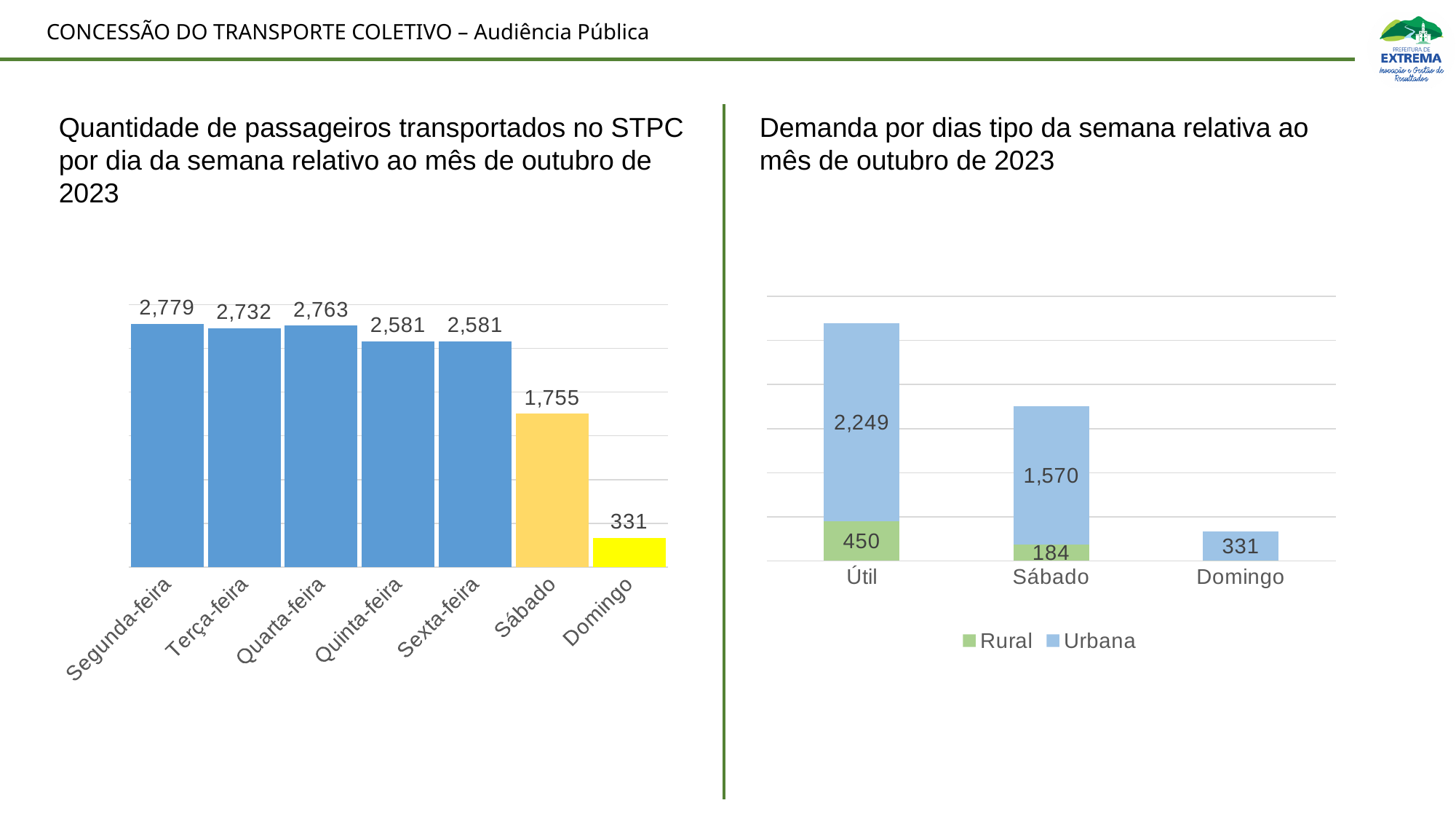
In the right chart, what is the total of the stacked bar for Útil? 2,699 How many series does the legend of the right chart list? 2 In the left chart, which is larger, the value for Terça-feira or the value for Quarta-feira? Quarta-feira In the right chart, what is the Urbana value for Sábado? 1,570 In the left chart, which day of the week has the lowest number of passengers? Domingo What kind of chart is the left chart? Bar chart In the left chart, which day of the week has the highest number of passengers? Segunda-feira In the left chart, how many passengers were transported on Segunda-feira? 2,779 In the left chart, how many days of the week are plotted? 7 In the right chart, what is the difference between the Urbana values for Útil and Sábado? 679 In the left chart, what is the difference between the values for Sábado and Domingo? 1,424 In the right chart, what is the Rural value for Útil? 450